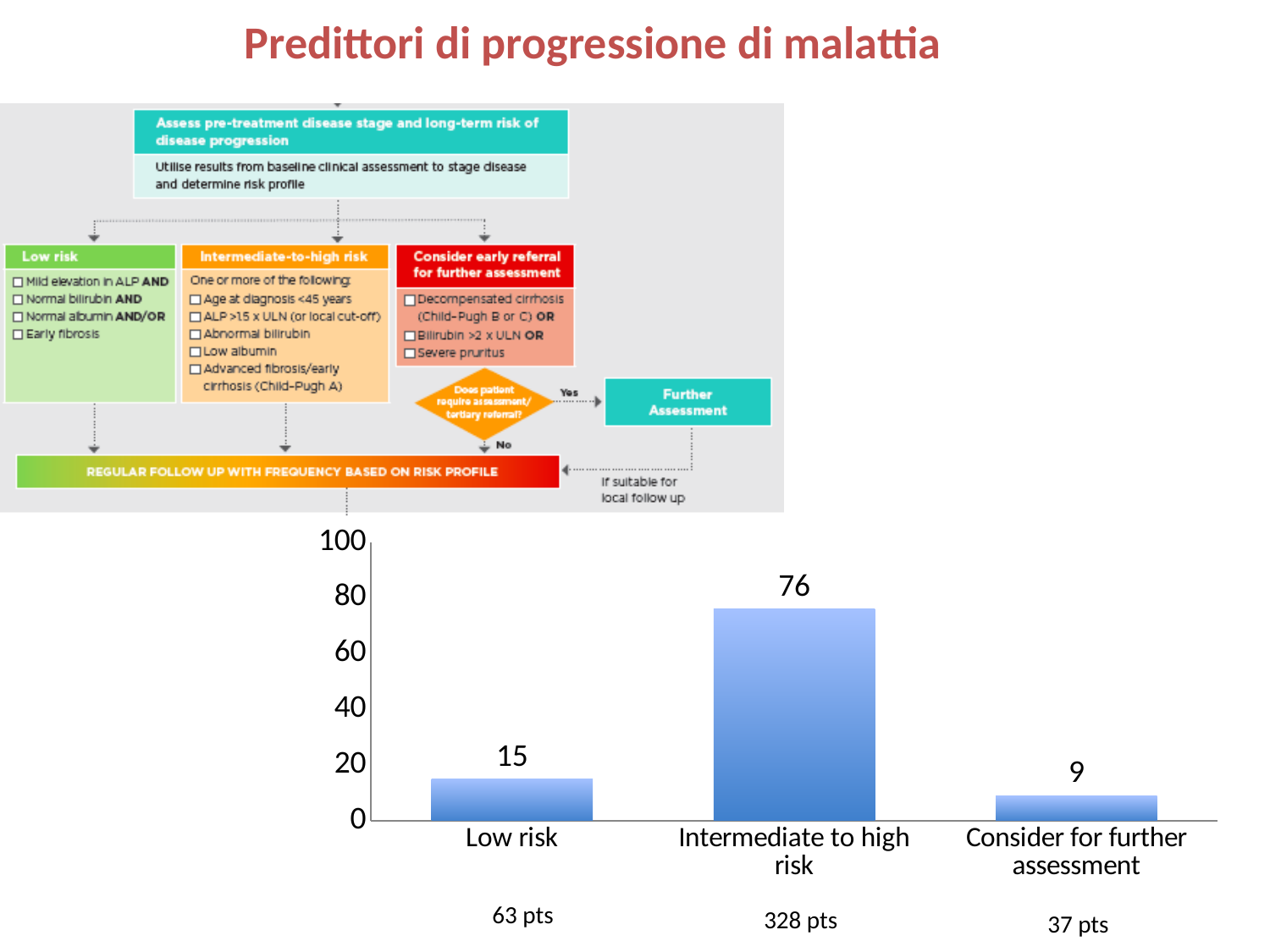
Is the value for Intermediate to high risk greater or less than 60? greater What is the value for Low risk? 15 Which category has the highest value? Intermediate to high risk What kind of chart is shown at the bottom of the slide? bar chart What is the value for Consider for further assessment? 9 How many categories are shown in the bar chart? 3 What is the difference between the values for Intermediate to high risk and Low risk? 61 What is the value for Intermediate to high risk? 76 What is the difference between the values for Low risk and Consider for further assessment? 6 Which category has the lowest value? Consider for further assessment What is the maximum value shown on the vertical axis of the bar chart? 100 Which is larger, the value for Low risk or the value for Consider for further assessment? Low risk